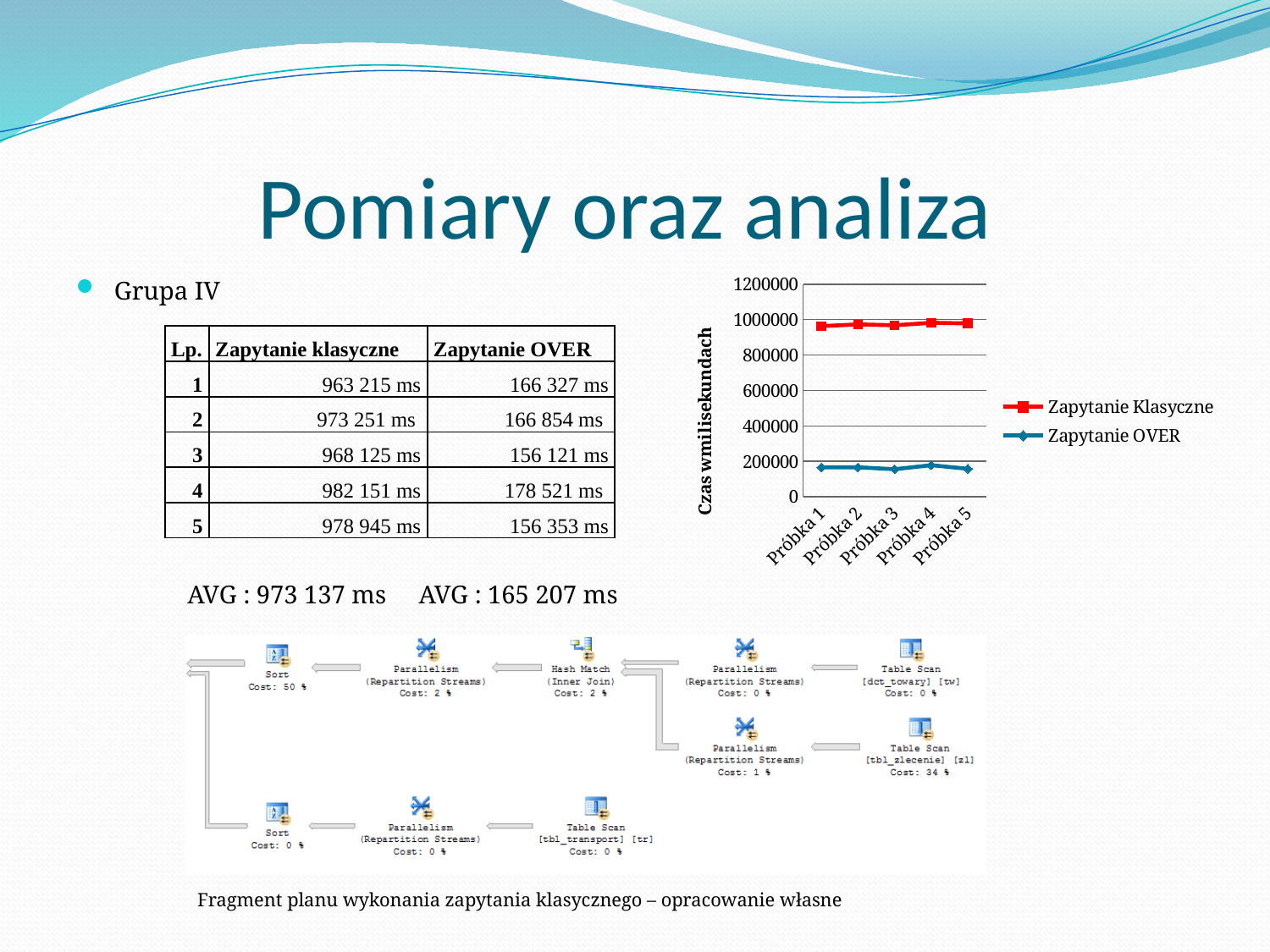
Is the value for Zapytanie Klasyczne at Próbka 5 greater or less than 600000? greater Is the value for Zapytanie OVER at Próbka 4 greater or less than 600000? less What kind of chart is shown on the slide? line chart Which colour is used for the Zapytanie Klasyczne series in the chart? red How many series does the chart's legend list? 2 How many samples (Próbka) are plotted along the x axis of the chart? 5 What is the label of the chart's vertical axis? Czas w milisekundach Is the value for Zapytanie Klasyczne at Próbka 1 greater or less than 800000? greater Which series has the lower values across all samples in the chart? Zapytanie OVER At Próbka 3, which series has the larger value, Zapytanie Klasyczne or Zapytanie OVER? Zapytanie Klasyczne